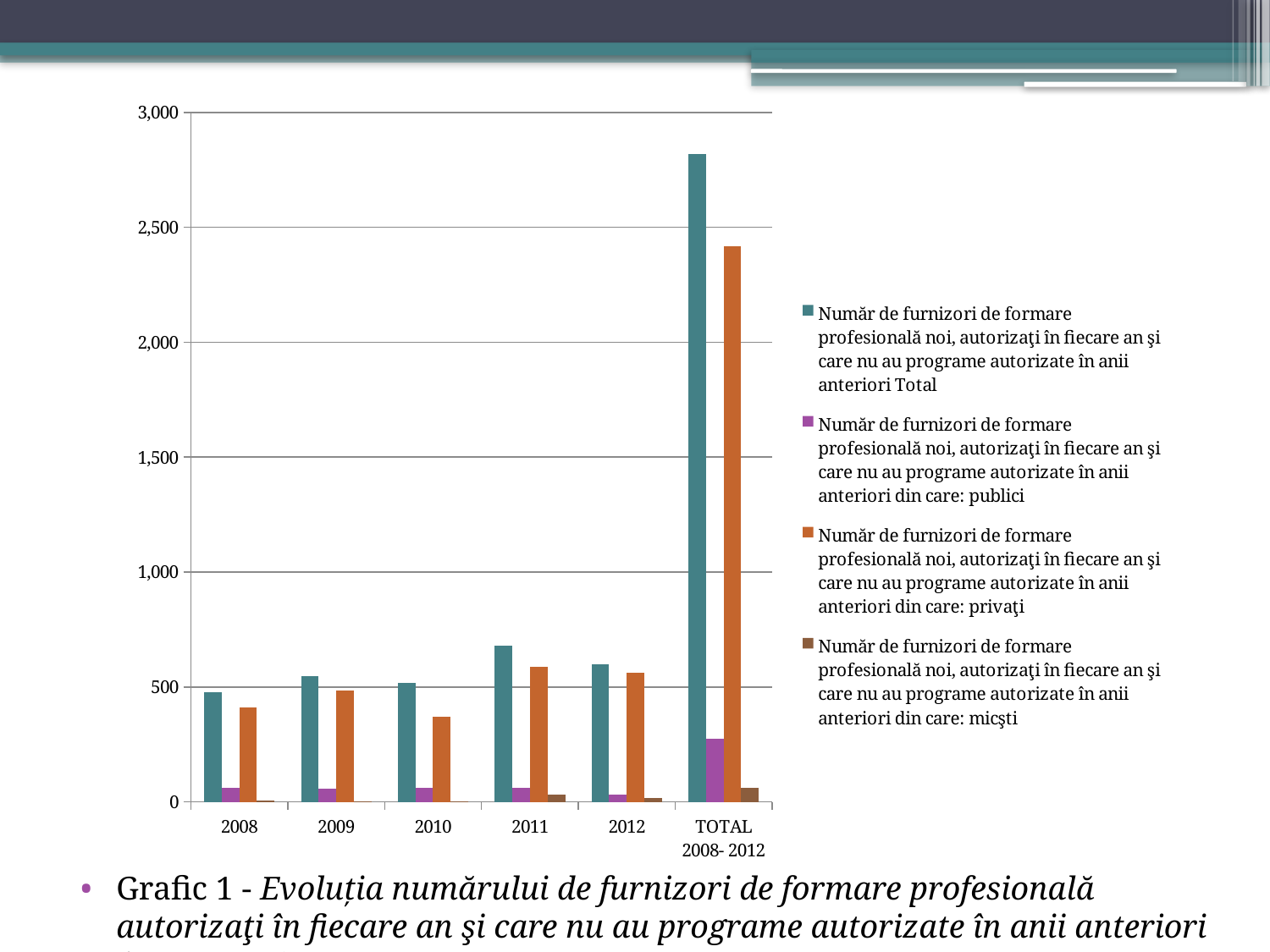
What colour are the bars for the 'din care: privaţi' series? orange Is the value of the 'din care: privaţi' series for TOTAL 2008-2012 greater or less than 2,000? greater For the 'Total' series, which is larger: the value for 2011 or the value for 2012? 2011 For TOTAL 2008-2012, which is larger: the 'din care: publici' value or the 'din care: micşti' value? din care: publici Is the value of the 'Total' series for 2011 greater or less than 500? greater How many categories are shown on the x axis of the chart? 6 How many series does the chart's legend list? 4 Is the value of the 'din care: privaţi' series for 2010 greater or less than 500? less Among the individual years 2008 to 2012, which year has the lowest value for the 'din care: privaţi' series (orange bars)? 2010 What kind of chart is shown on the slide? bar chart Among the individual years 2008 to 2012, which year has the highest value for the 'Total' series (teal bars)? 2011